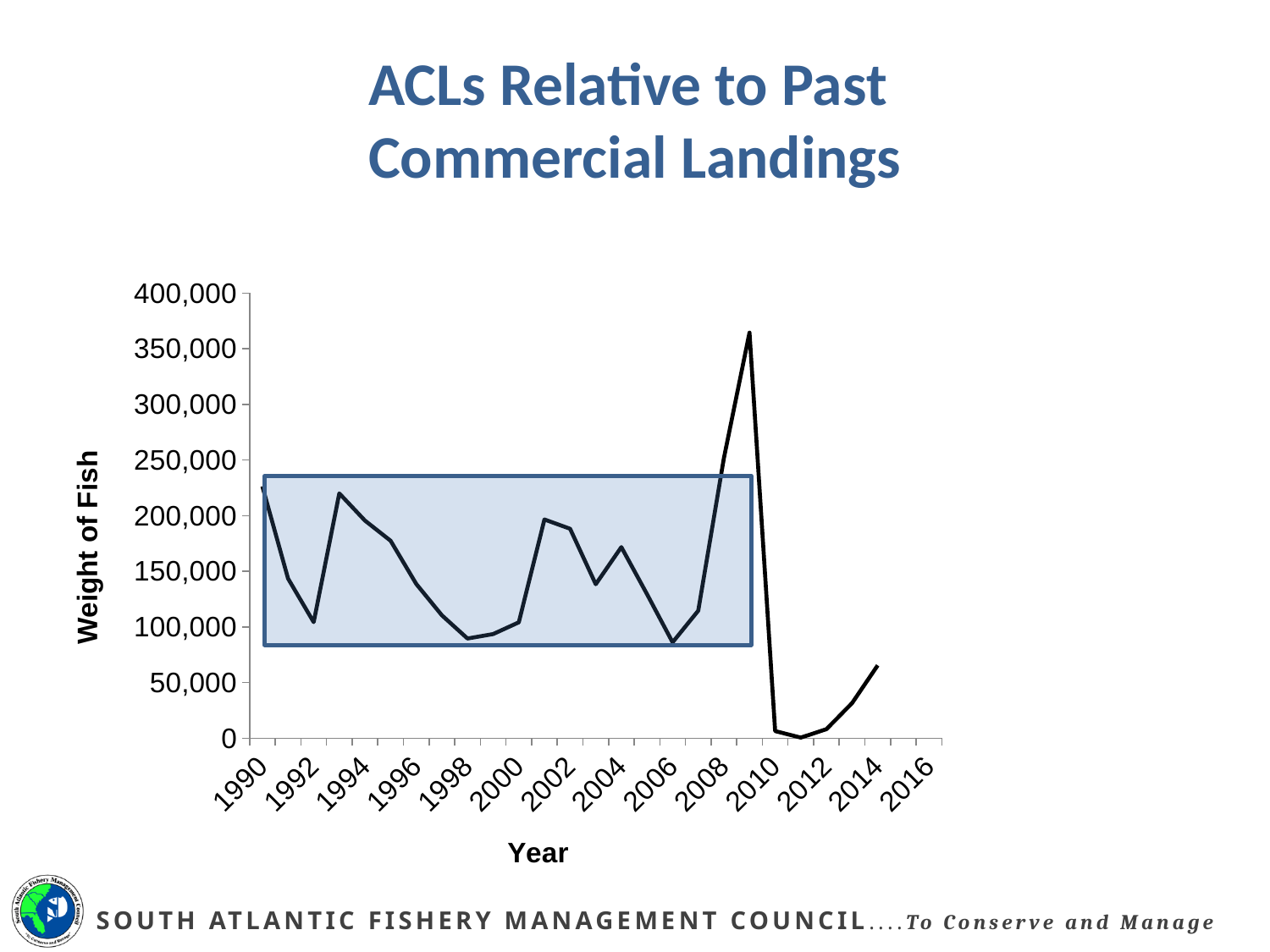
Does the line rise or fall between 2009 and 2011? fall In which year does the line reach its lowest value? 2011 What is the title of the chart on the slide? ACLs Relative to Past Commercial Landings Is the value for 2011 greater or less than 50,000? less Is the value for 2009 greater or less than 300,000? greater What kind of chart is shown on the slide? line chart What is the label on the vertical axis of the chart? Weight of Fish Which year has the larger value, 1990 or 1998? 1990 Is the value for 1990 greater or less than 200,000? greater In which year does the line reach its highest value? 2009